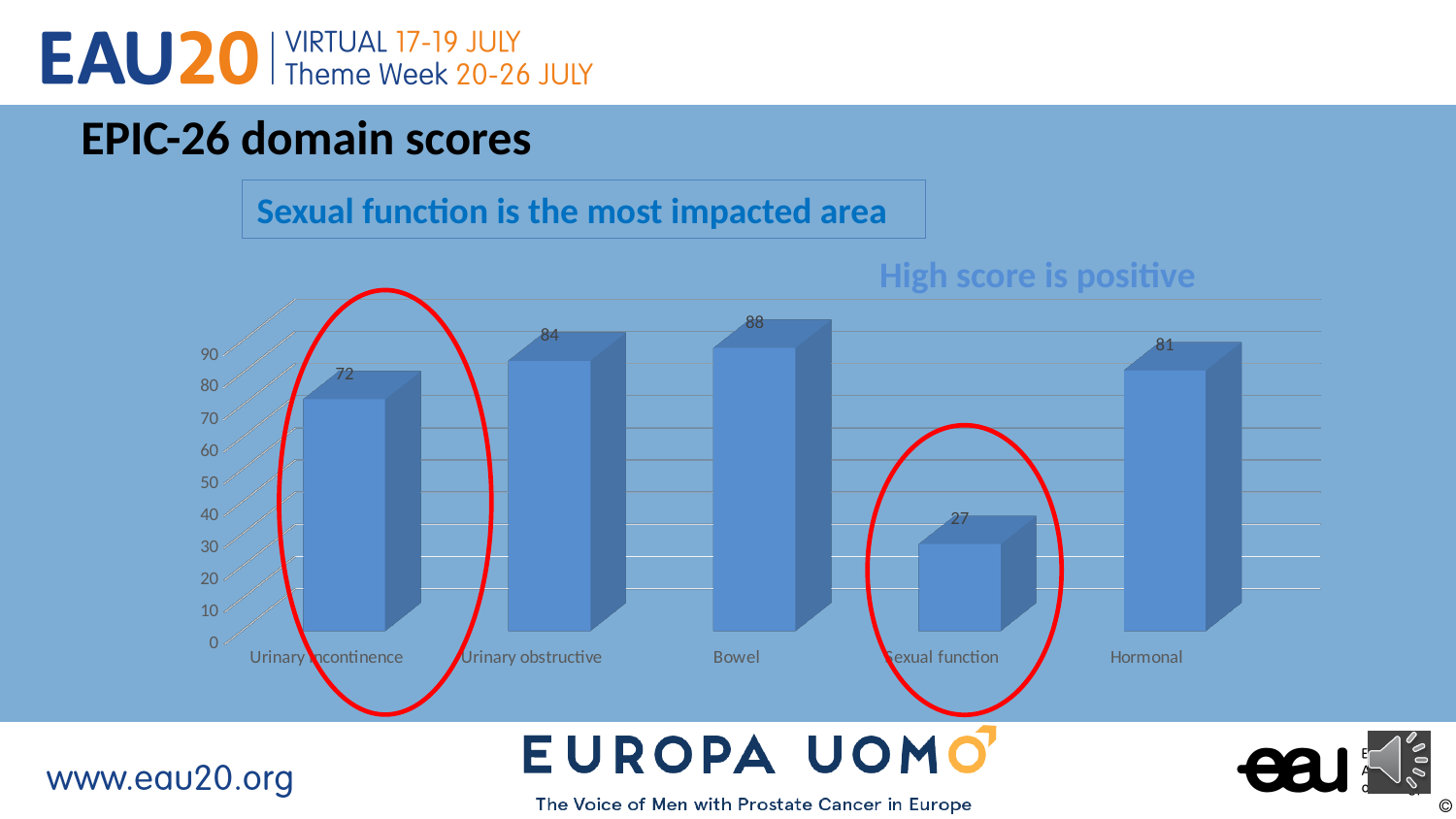
What is the score for Bowel? 88 What is the score for Hormonal? 81 What is the difference between the Urinary obstructive score and the Urinary incontinence score? 12 What is the title of the chart on the slide? EPIC-26 domain scores Which has a higher score, Hormonal or Urinary incontinence? Hormonal Which domain has the lowest score? Sexual function What kind of chart is shown on the slide? Bar chart What is the difference between the Bowel score and the Sexual function score? 61 What is the EPIC-26 domain score for Sexual function? 27 What is the score for Urinary incontinence? 72 Which domain has the highest score? Bowel How many domains are plotted in the chart? 5